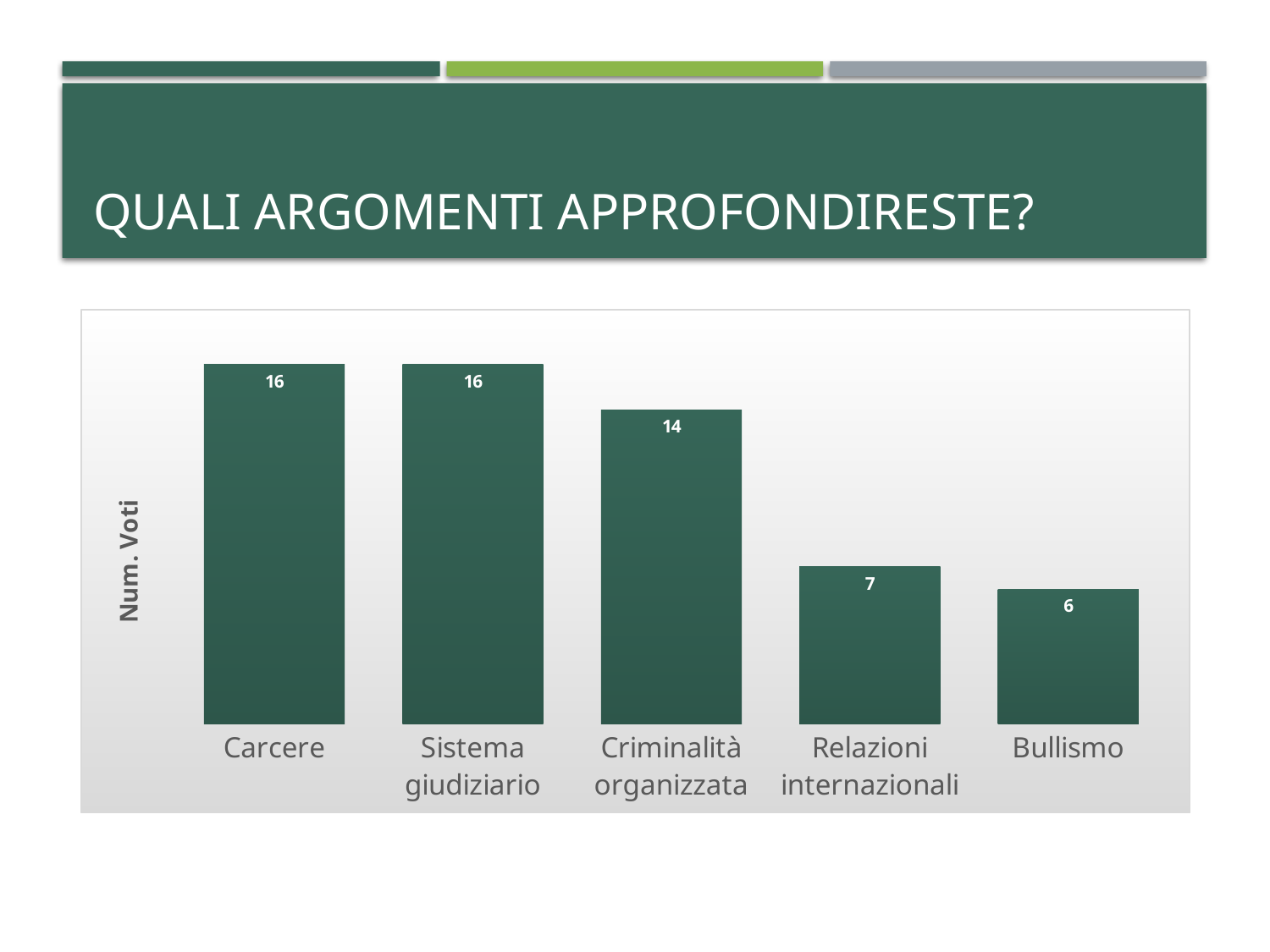
How many categories are shown in the chart? 5 Which category has the lowest value? Bullismo What is the difference between the values for Criminalità organizzata and Bullismo? 8 What is the value for Criminalità organizzata? 14 What is the value for Sistema giudiziario? 16 What kind of chart is shown on the slide? Bar chart What is the label of the vertical axis? Num. Voti Which is larger, the value for Relazioni internazionali or the value for Bullismo? Relazioni internazionali What is the difference between the values for Carcere and Criminalità organizzata? 2 What is the value for Relazioni internazionali? 7 What is the value for Carcere? 16 What is the value for Bullismo? 6